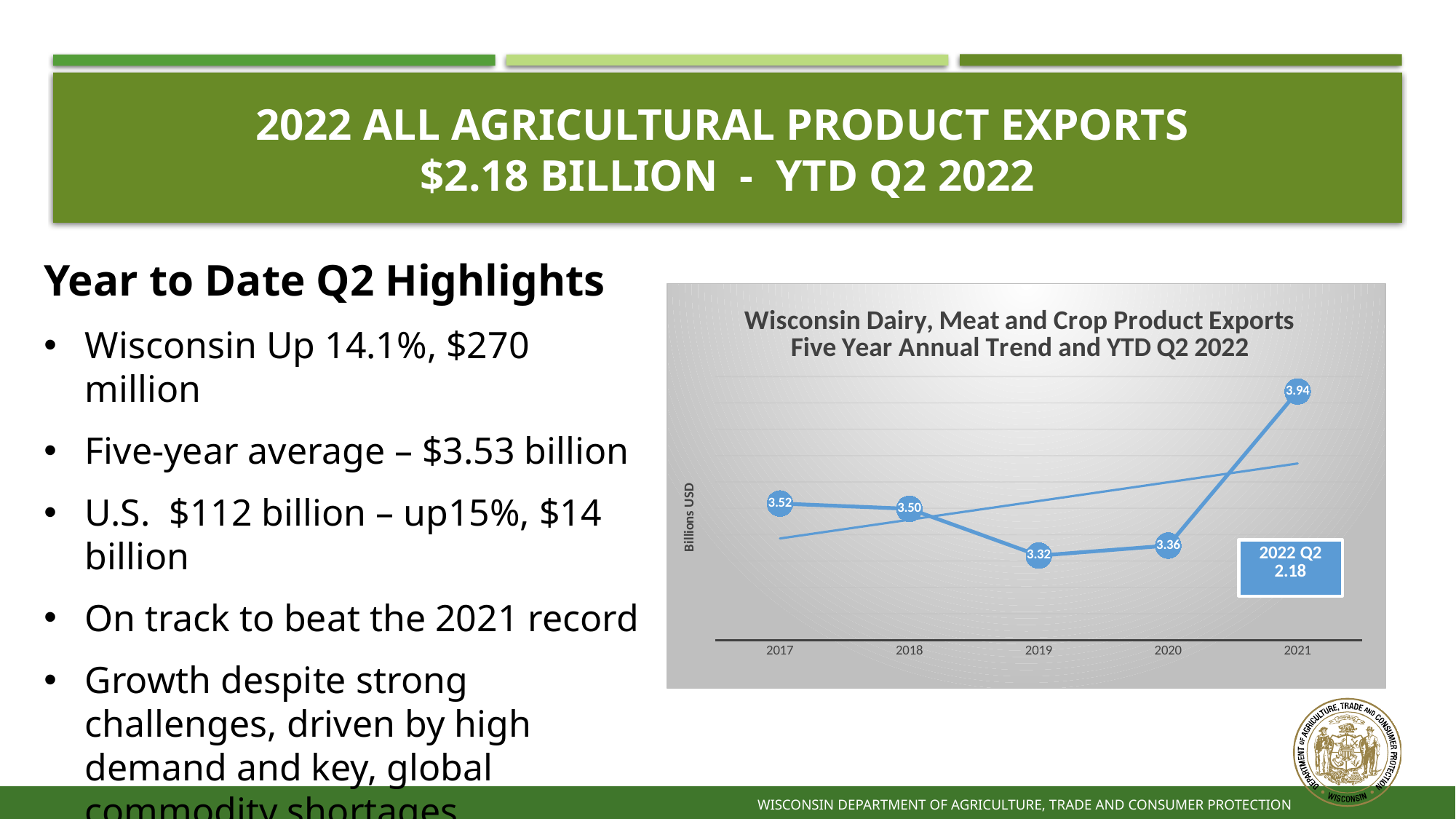
What is the label on the vertical axis of the chart? Billions USD What value is shown in the 2022 Q2 box on the chart? 2.18 What type of chart is shown on the slide? line chart Which year has the highest value in the chart? 2021 Which year has the lowest value in the chart? 2019 Does the line rise or fall from 2020 to 2021? rise What is the value for 2019 in the chart? 3.32 Which is larger, the value for 2017 or the value for 2018? 2017 What is the value for 2021 in the chart? 3.94 How many years are plotted on the x axis of the chart? 5 What is the value for 2017 in the Wisconsin Dairy, Meat and Crop Product Exports chart? 3.52 What is the difference between the 2021 value and the 2020 value? 0.58